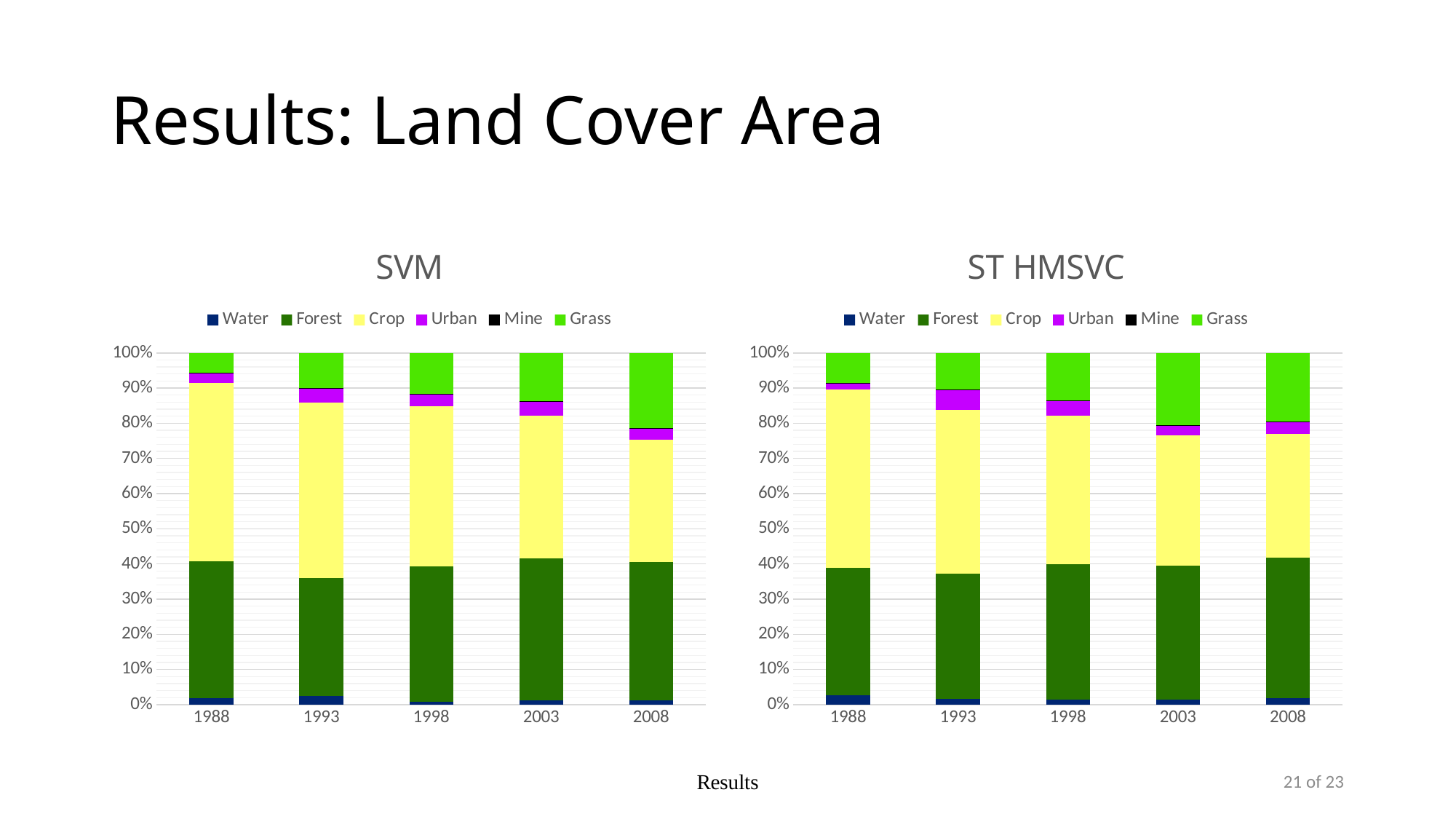
In the ST HMSVC chart, is the top of the Crop segment for 1988 greater or less than 80%? greater In the SVM chart, is the top of the Crop segment for 2008 greater or less than 80%? less In the ST HMSVC chart, which colour represents Crop? Yellow In the SVM chart, is the top of the Forest segment for 1993 greater or less than 40%? less What are the titles of the two charts on the slide? SVM and ST HMSVC How many years are shown on the x axis of the ST HMSVC chart? 5 In the SVM chart, which year has the smallest Forest segment? 1993 In the SVM chart, what is the total height of the stacked bar for 1988? 100% In the SVM chart, does the Grass segment get larger or smaller from 1988 to 2008? Larger What kind of chart is the SVM chart? Stacked bar chart How many series does the legend of the SVM chart list? 6